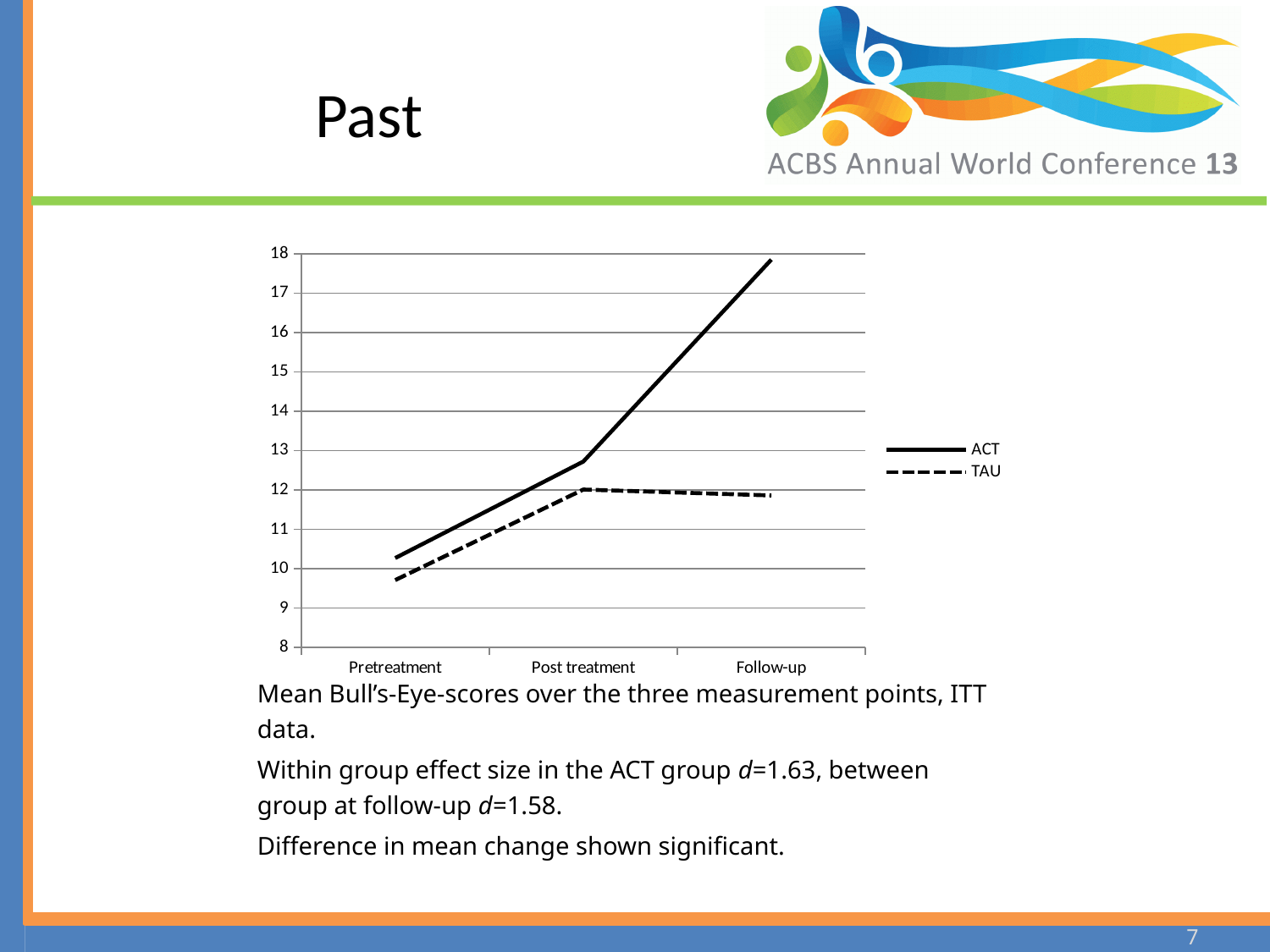
Is the value for TAU at Pretreatment greater or less than 10? less Is the value for TAU at Follow-up greater or less than 13? less At Pretreatment, which series has the larger value, ACT or TAU? ACT How many series does the legend list? 2 At which measurement point does the ACT series reach its highest value? Follow-up Which series is drawn with a dashed line? TAU Is the value for ACT at Pretreatment greater or less than 11? less Do the ACT values rise or fall from Pretreatment to Follow-up? rise How many measurement points are shown on the x axis? 3 What kind of chart is shown on the slide? line chart At Follow-up, which series has the larger value, ACT or TAU? ACT